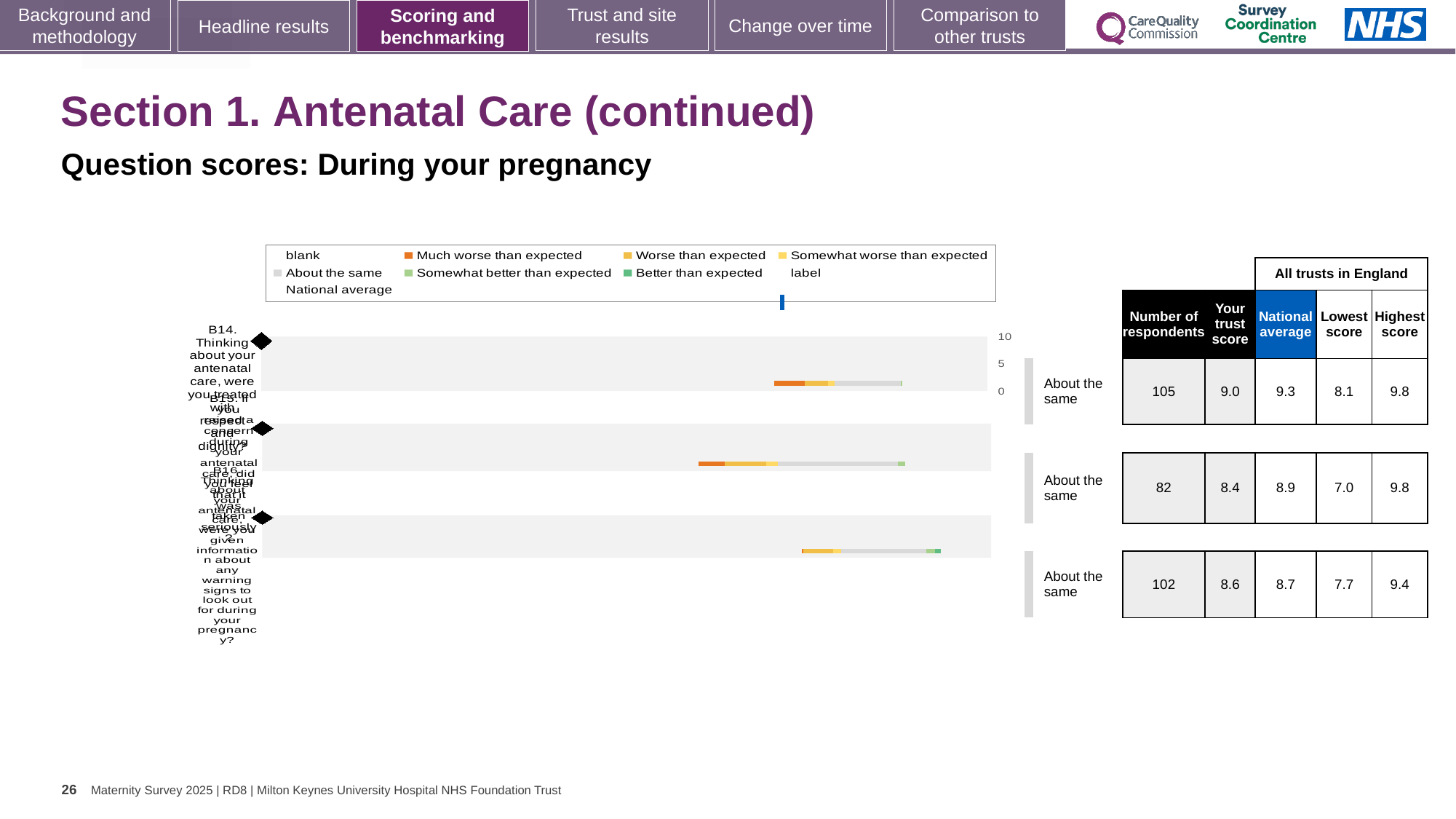
What is the lowest value in the 'Lowest score' column of the table next to the chart? 7.0 In the table next to the chart, what is the highest score in England for the third row? 9.4 In the table next to the chart, what is the national average for the third row? 8.7 For the third row, which is larger: the trust score or the national average? National average How many question rows are plotted in the chart? 3 In the table next to the chart, what is the number of respondents for the first row (B14, treated with respect and dignity)? 105 Which row has the highest 'Your trust score' in the table next to the chart? The first row (B14), 9.0 What kind of chart is shown on the slide? Bar chart In the table next to the chart, what is the 'Your trust score' for the second row? 8.4 For the first row (B14), what is the difference between the national average and the trust score? 0.3 What is the subtitle describing the chart's question scores? Question scores: During your pregnancy What benchmark category is shown for all three rows of the chart? About the same